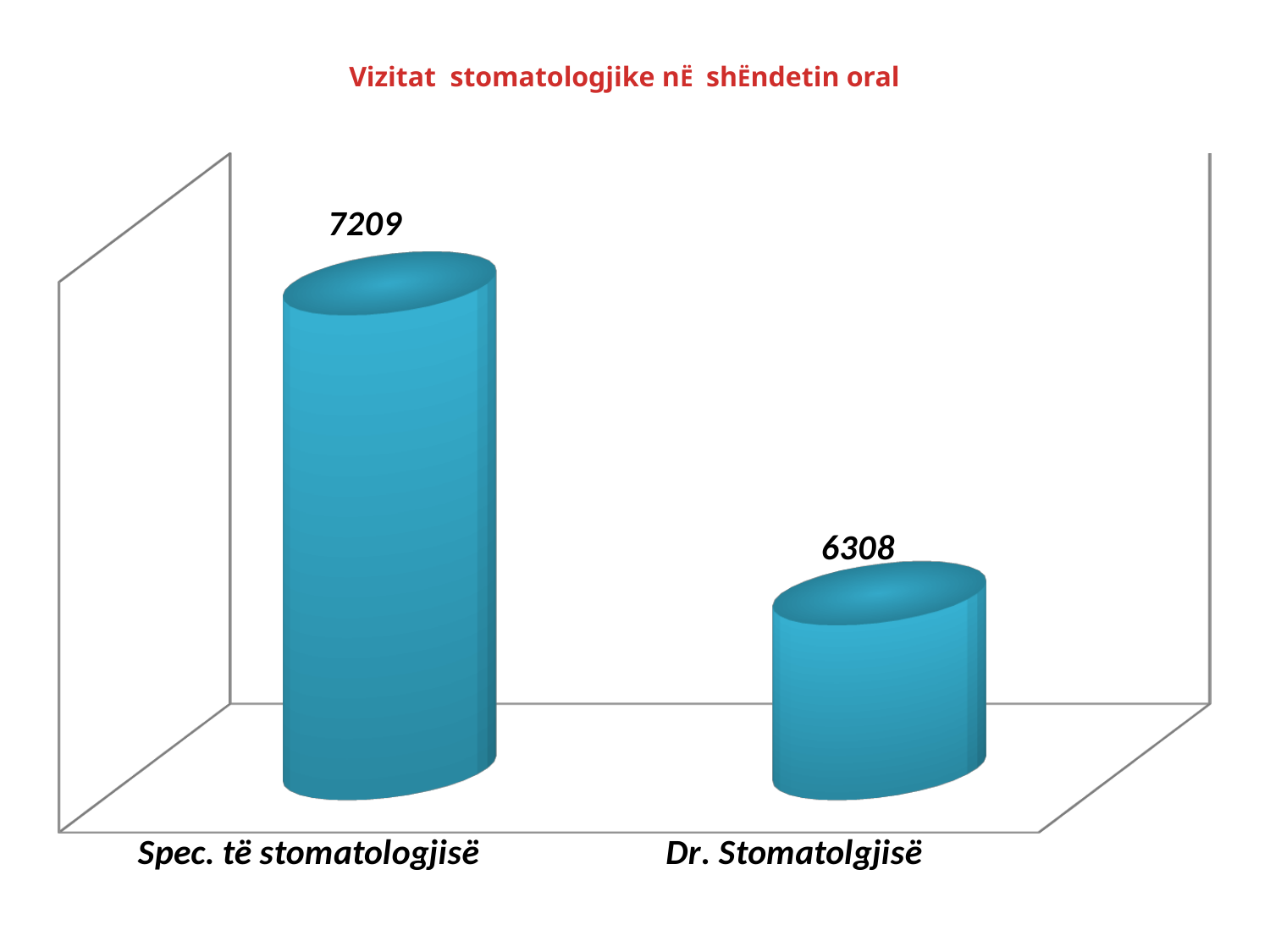
What is the total of the two values shown in the chart? 13517 Which is larger, the value for Spec. të stomatologjisë or the value for Dr. Stomatolgjisë? Spec. të stomatologjisë What kind of chart is shown on the slide? Bar chart What is the title of the chart? Vizitat stomatologjike në shëndetin oral What is the difference between the values for Spec. të stomatologjisë and Dr. Stomatolgjisë? 901 What colour are the bars in the chart? Blue Which category has the highest value? Spec. të stomatologjisë How many categories are shown in the chart? 2 What is the value for Spec. të stomatologjisë? 7209 Which category has the lowest value? Dr. Stomatolgjisë What is the value for Dr. Stomatolgjisë? 6308